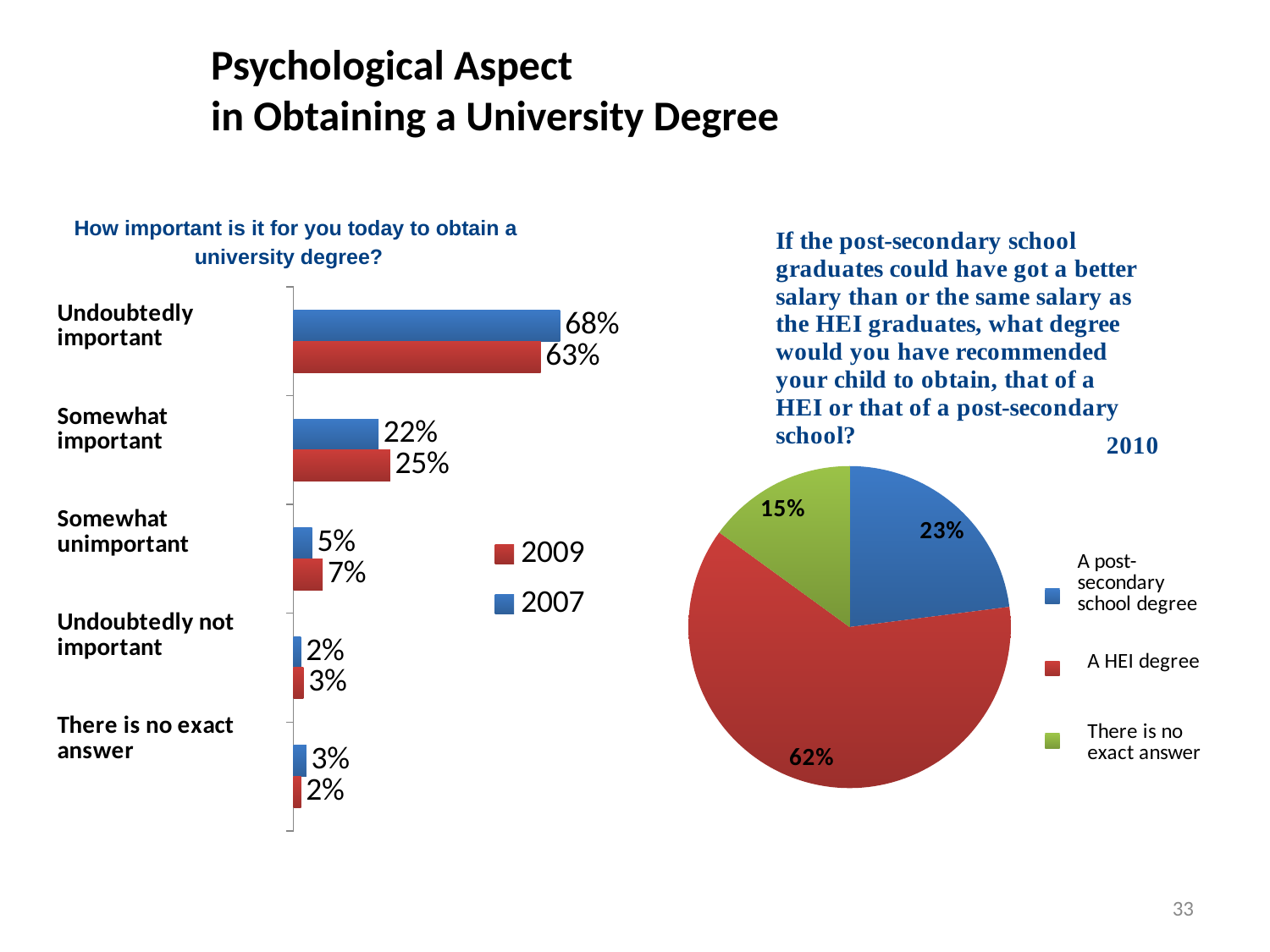
In the pie chart on the right, what is the difference between the 'A post-secondary school degree' and 'There is no exact answer' slices? 8% In the pie chart on the right, what share is 'A HEI degree'? 62% In the bar chart on the left, what is the 2009 value for 'Somewhat important'? 25% In the pie chart on the right, which slice is the smallest? There is no exact answer In the bar chart on the left, what is the 2007 value for 'Undoubtedly important'? 68% How many categories does the bar chart on the left show? 5 In the bar chart on the left, what is the difference between the 2007 and 2009 values for 'Undoubtedly important'? 5% In the bar chart on the left, what is the 2009 value for 'Somewhat unimportant'? 7% In the bar chart on the left, which category has the highest value for 2007? Undoubtedly important How many series does the legend of the bar chart on the left list? 2 In the bar chart on the left, which is larger for 'Somewhat important': the 2007 value or the 2009 value? 2009 What kind of chart is the chart on the left? Bar chart